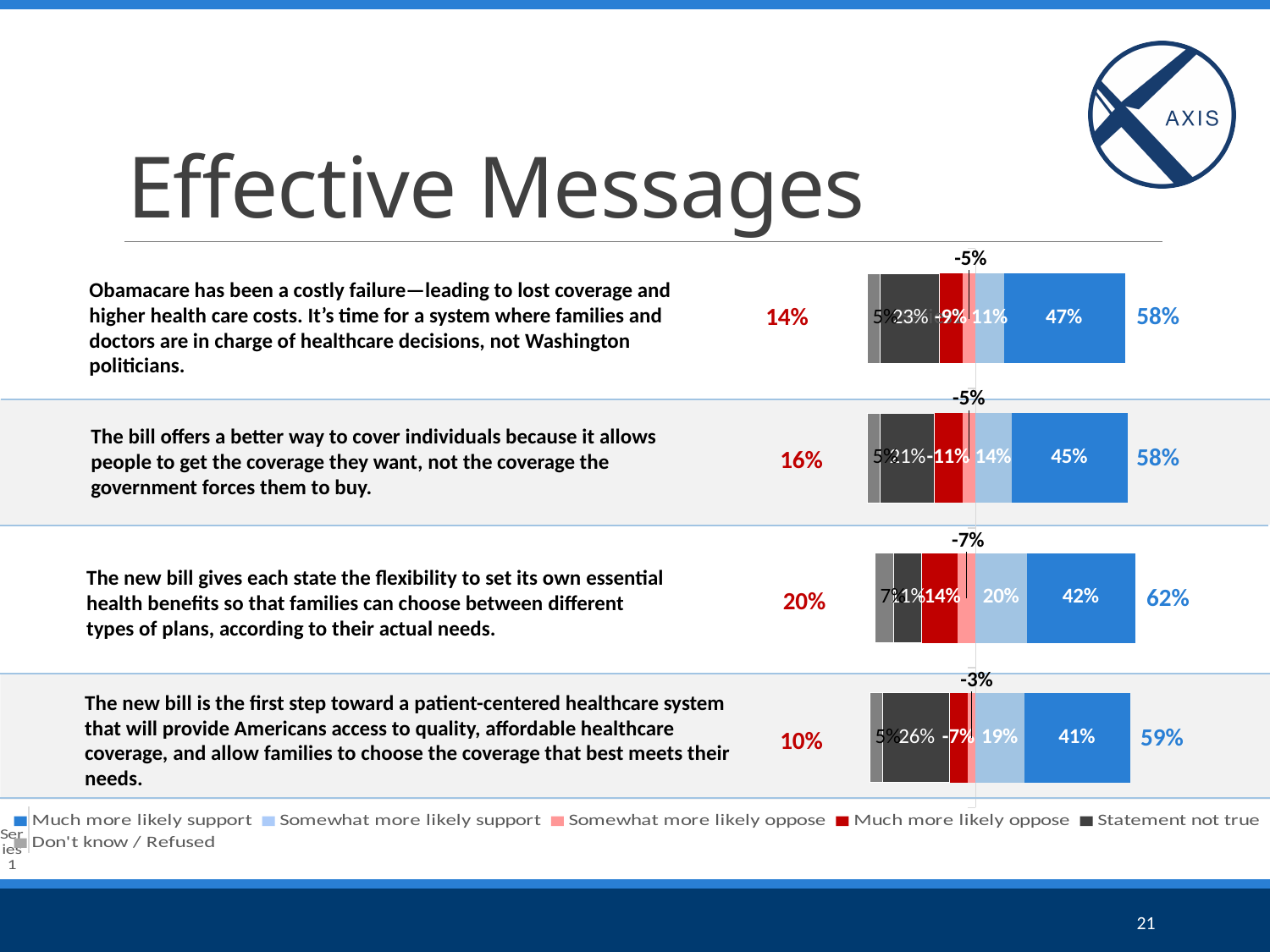
What is the 'Somewhat more likely support' value for the statement 'The new bill is the first step toward a patient-centered healthcare system...'? 19% Which statement has the lowest 'Much more likely support' value? The new bill is the first step toward a patient-centered healthcare system... What is the 'Much more likely support' value for the statement 'The new bill gives each state the flexibility...'? 42% Which statement has the lowest total oppose figure shown in red on the left? The new bill is the first step toward a patient-centered healthcare system... (10%) What is the 'Much more likely support' value for the statement 'Obamacare has been a costly failure...'? 47% What kind of chart is shown on the slide? Bar chart How many statements (bars) are plotted in the chart? 4 Which statement has the highest total support figure shown in blue on the right? The new bill gives each state the flexibility... (62%) What is the difference between the 'Much more likely support' values for the 'Obamacare has been a costly failure...' statement (47%) and the 'first step toward a patient-centered healthcare system' statement (41%)? 6 percentage points Is the 'Somewhat more likely support' value larger for the 'state flexibility' statement or the 'Obamacare costly failure' statement? The state flexibility statement (20% vs 11%) Which statement has the highest 'Much more likely support' value? Obamacare has been a costly failure... How many series does the legend list? 6